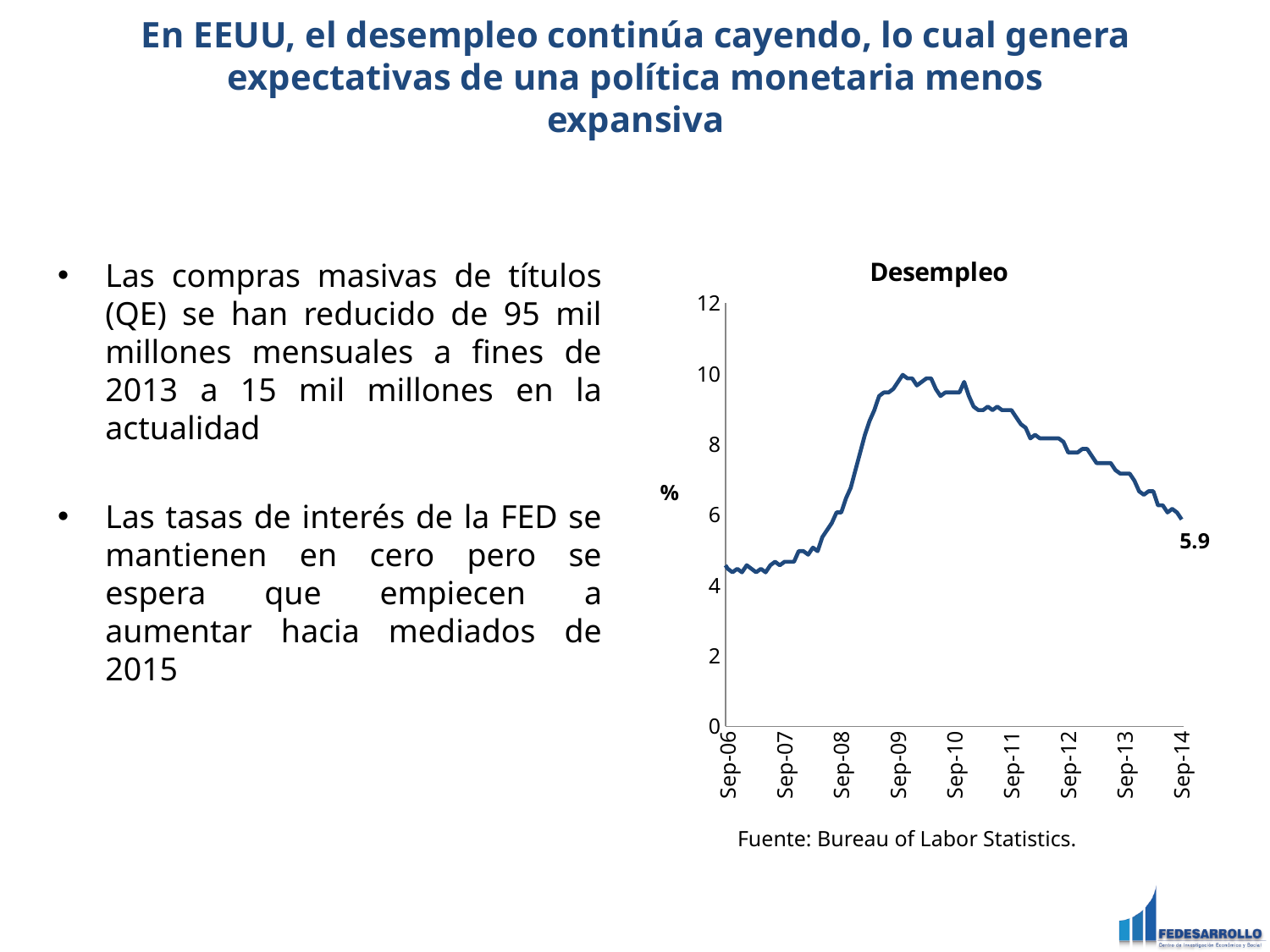
What is the unemployment value shown for Sep-14? 5.9 Is the value for Sep-06 greater or less than 6? less Does the unemployment rate rise or fall between Sep-09 and Sep-14? fall Is the value for Sep-13 greater or less than 8? less What unit is indicated on the y axis of the chart? % What kind of chart is shown on the slide? line chart How many date labels are shown on the x axis? 9 Which is larger, the value at Sep-09 or the value at Sep-13? Sep-09 What is the title of the chart? Desempleo Is the value for Sep-07 greater or less than 6? less Does the unemployment rate rise or fall between Sep-06 and Sep-09? rise